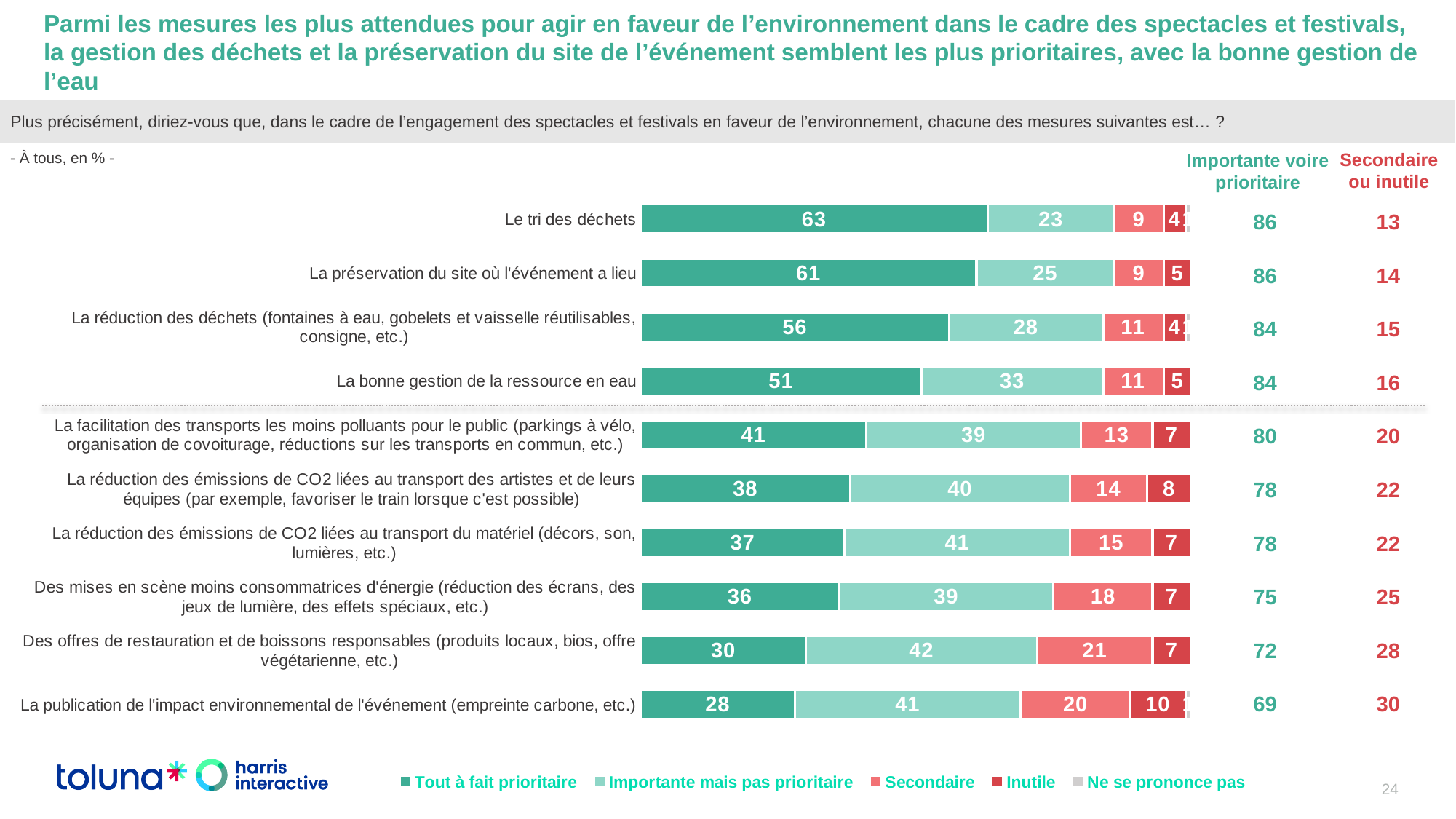
What kind of chart is shown on the slide? Stacked bar chart How many series does the legend list? 5 What is the value of "Tout à fait prioritaire" for "Le tri des déchets"? 63 Which has the larger "Inutile" value: "La publication de l'impact environnemental de l'événement" or "La réduction des émissions de CO2 liées au transport des artistes et de leurs équipes"? La publication de l'impact environnemental de l'événement Which measure has the lowest "Tout à fait prioritaire" value? La publication de l'impact environnemental de l'événement (empreinte carbone, etc.) Which measure has the highest "Secondaire" value? Des offres de restauration et de boissons responsables (produits locaux, bios, offre végétarienne, etc.) What is the difference in "Tout à fait prioritaire" between "Le tri des déchets" and "La préservation du site où l'événement a lieu"? 2 What is the value of "Importante mais pas prioritaire" for "La bonne gestion de la ressource en eau"? 33 What is the "Inutile" value for "La publication de l'impact environnemental de l'événement (empreinte carbone, etc.)"? 10 What is the "Importante voire prioritaire" total shown for "La facilitation des transports les moins polluants pour le public"? 80 How many measures (categories) are shown in the chart? 10 Which measure has the highest "Tout à fait prioritaire" value? Le tri des déchets